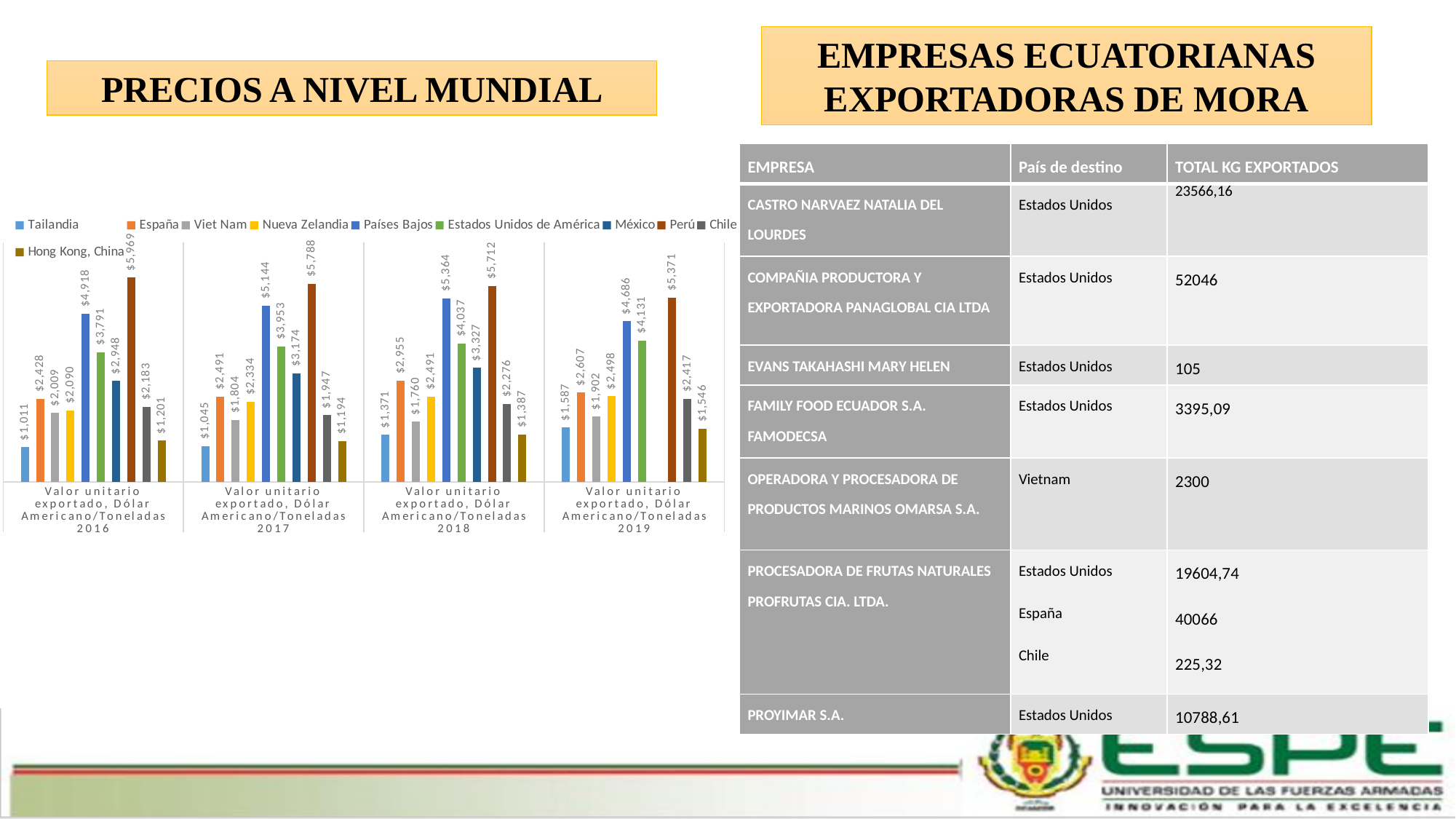
What is the value for Perú in 2016? $5,969 What is the value for Hong Kong, China in 2017? $1,194 What is the difference between Perú and Países Bajos in 2019? $685 Which is larger in 2018: the value for Estados Unidos de América or the value for México? Estados Unidos de América What is the value for Tailandia in 2019? $1,587 Does the value for Tailandia rise or fall from 2016 to 2019? Rise What kind of chart is shown under the title 'PRECIOS A NIVEL MUNDIAL'? Bar chart What is the value for Países Bajos in 2018? $5,364 How many year groups are shown on the x axis of the chart? 4 How many series does the legend of the chart list? 10 Which country has the highest value in 2017? Perú Which country has the lowest value in 2016? Tailandia